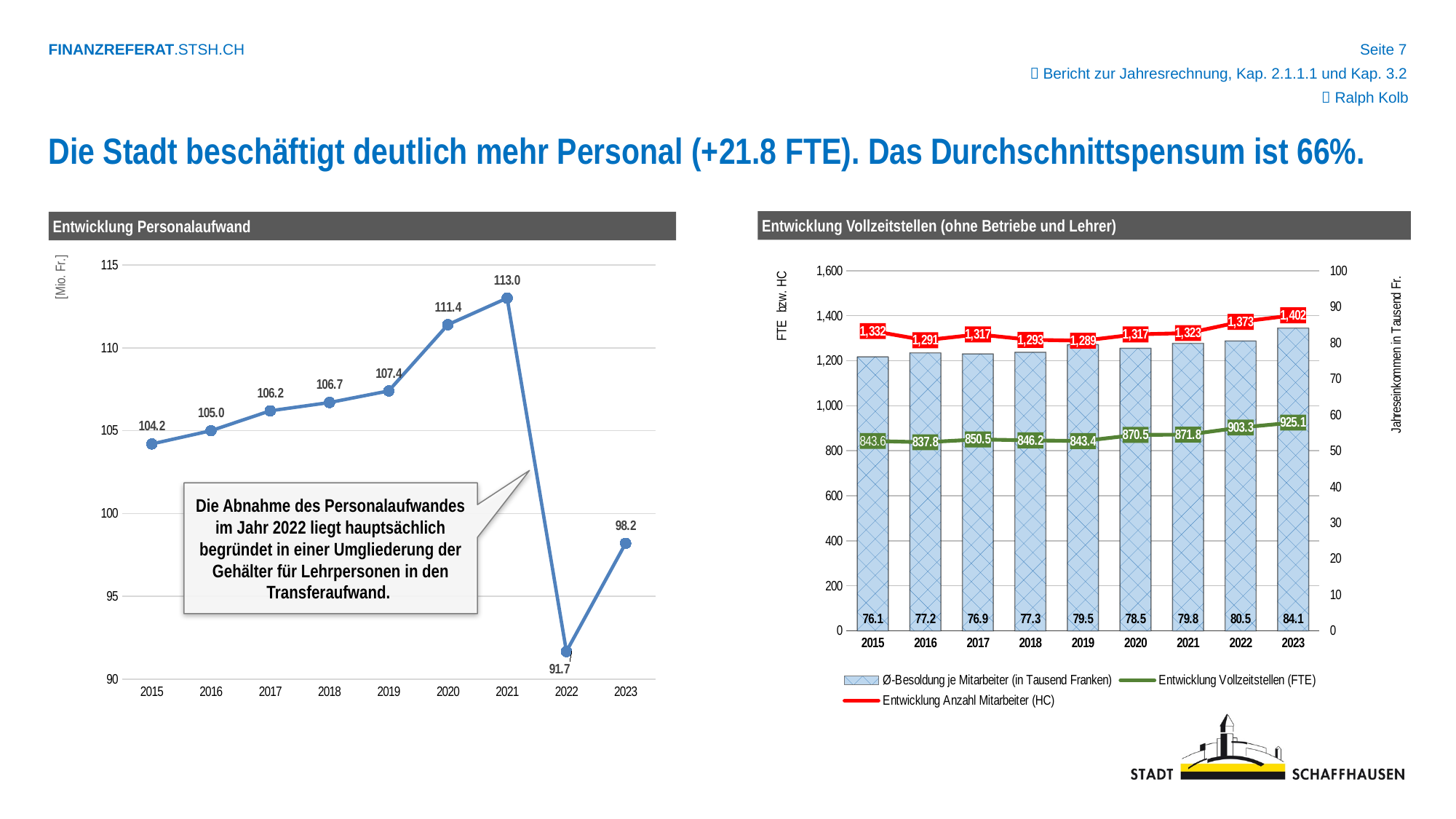
In the 'Entwicklung Personalaufwand' chart, what is the difference between the values for 2021 and 2022? 21.3 In the 'Entwicklung Vollzeitstellen (ohne Betriebe und Lehrer)' chart, what is the value of 'Entwicklung Vollzeitstellen (FTE)' for 2023? 925.1 In the 'Entwicklung Personalaufwand' chart, what is the value for 2021? 113.0 In the 'Entwicklung Personalaufwand' chart, do the values rise or fall from 2015 to 2021? Rise In the 'Entwicklung Vollzeitstellen (ohne Betriebe und Lehrer)' chart, how many series does the legend list? 3 What kind of chart is 'Entwicklung Personalaufwand'? Line chart In the 'Entwicklung Vollzeitstellen (ohne Betriebe und Lehrer)' chart, which year has the highest 'Entwicklung Anzahl Mitarbeiter (HC)' value? 2023 In the 'Entwicklung Vollzeitstellen (ohne Betriebe und Lehrer)' chart, what is the value of 'Ø-Besoldung je Mitarbeiter (in Tausend Franken)' for 2015? 76.1 In the 'Entwicklung Vollzeitstellen (ohne Betriebe und Lehrer)' chart, what is the value of 'Entwicklung Anzahl Mitarbeiter (HC)' for 2019? 1,289 In the 'Entwicklung Personalaufwand' chart, which year has the lowest value? 2022 In the 'Entwicklung Personalaufwand' chart, how many years are plotted on the x axis? 9 In the 'Entwicklung Vollzeitstellen (ohne Betriebe und Lehrer)' chart, what is the difference between the 'Entwicklung Vollzeitstellen (FTE)' values for 2023 and 2022? 21.8